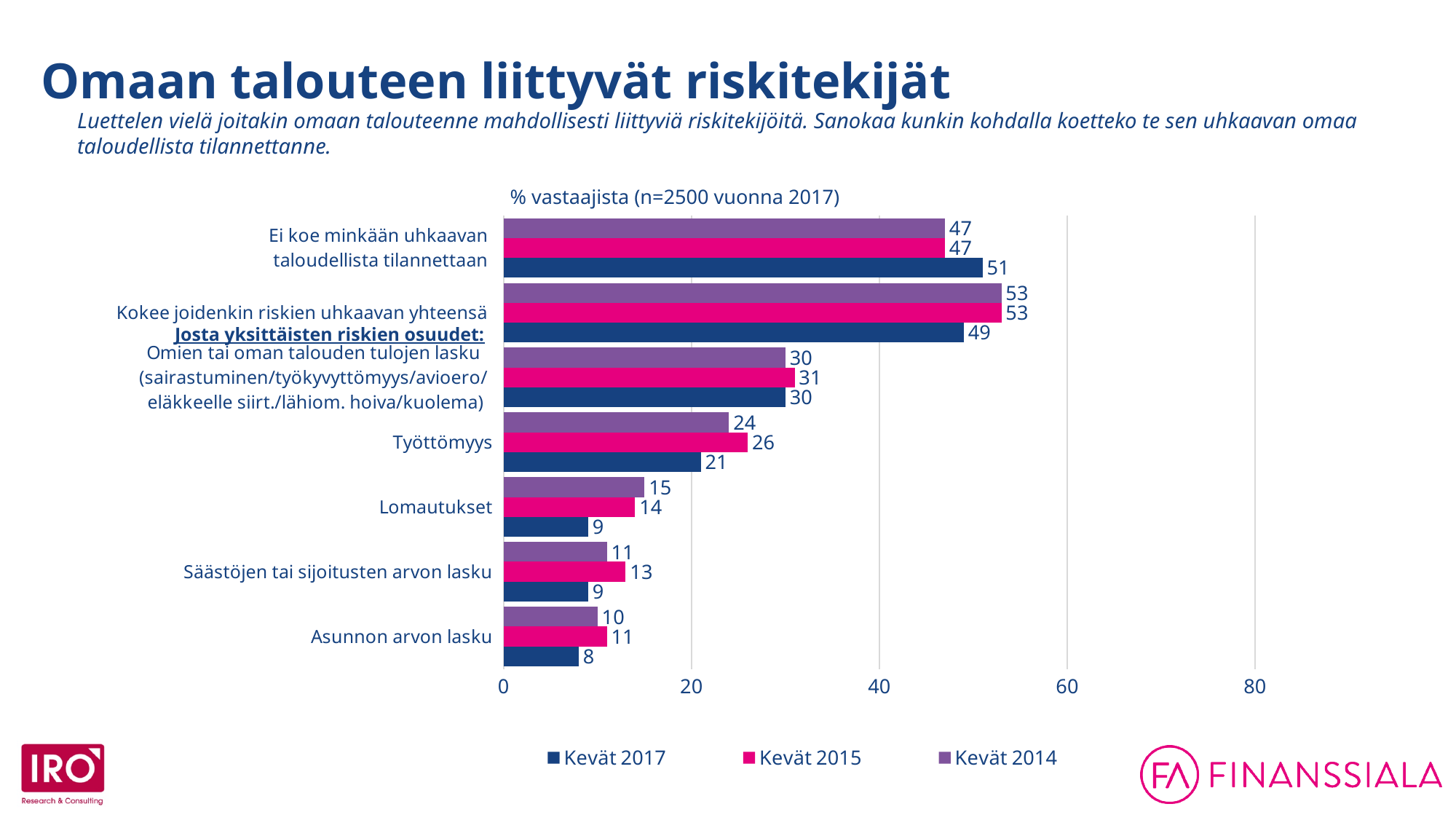
What is the Kevät 2015 value for Lomautukset? 14 What is the title shown above the chart? % vastaajista (n=2500 vuonna 2017) Which category has the lowest Kevät 2017 value? Asunnon arvon lasku What is the difference between the Kevät 2015 and Kevät 2017 values for Lomautukset? 5 What is the Kevät 2017 value for Ei koe minkään uhkaavan taloudellista tilannettaan? 51 Which is larger for Työttömyys: the Kevät 2015 value or the Kevät 2017 value? Kevät 2015 How many categories are shown on the chart? 7 What kind of chart is shown on the slide? Bar chart How many series does the legend list? 3 What is the Kevät 2014 value for Asunnon arvon lasku? 10 Which category has the highest Kevät 2015 value? Kokee joidenkin riskien uhkaavan yhteensä What is the Kevät 2017 value for Työttömyys? 21